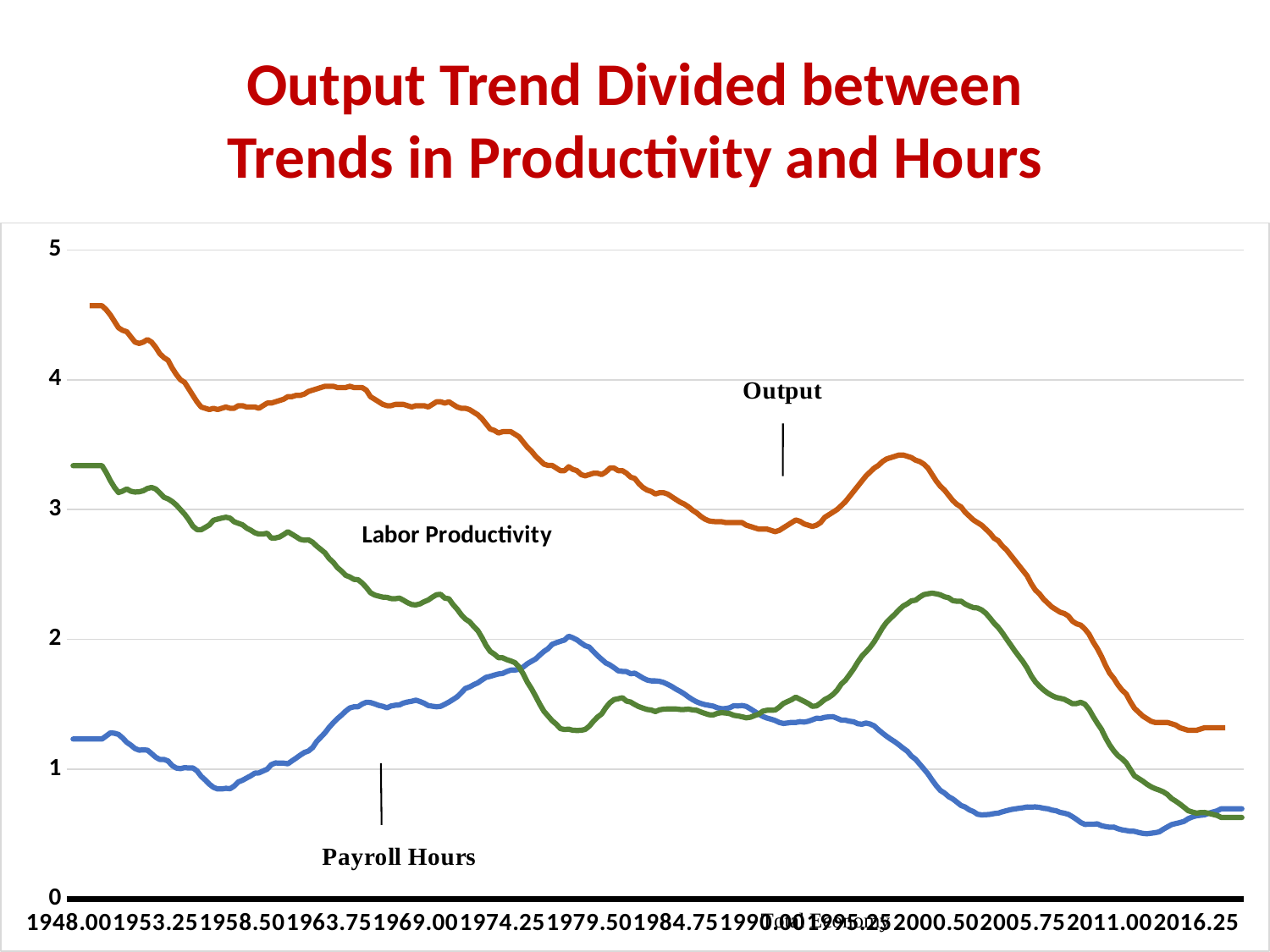
Around 2000.50, which is larger: Output or Labor Productivity? Output Which series has the lowest value at the start of the chart (1948.00)? Payroll Hours Does the Output line rise or fall overall from 1948.00 to 2016.25? Falls How many series (lines) are plotted on the chart? 3 Is the value of Payroll Hours at 1948.00 greater or less than 2? less What kind of chart is shown on the slide? Line chart Which series has the highest value at the start of the chart (1948.00)? Output Is the value of Labor Productivity at 1948.00 greater or less than 3? greater Is the value of Output at 1948.00 greater or less than 4? greater Around 1979.50, which is larger: Payroll Hours or Labor Productivity? Payroll Hours What is the title of the slide? Output Trend Divided between Trends in Productivity and Hours